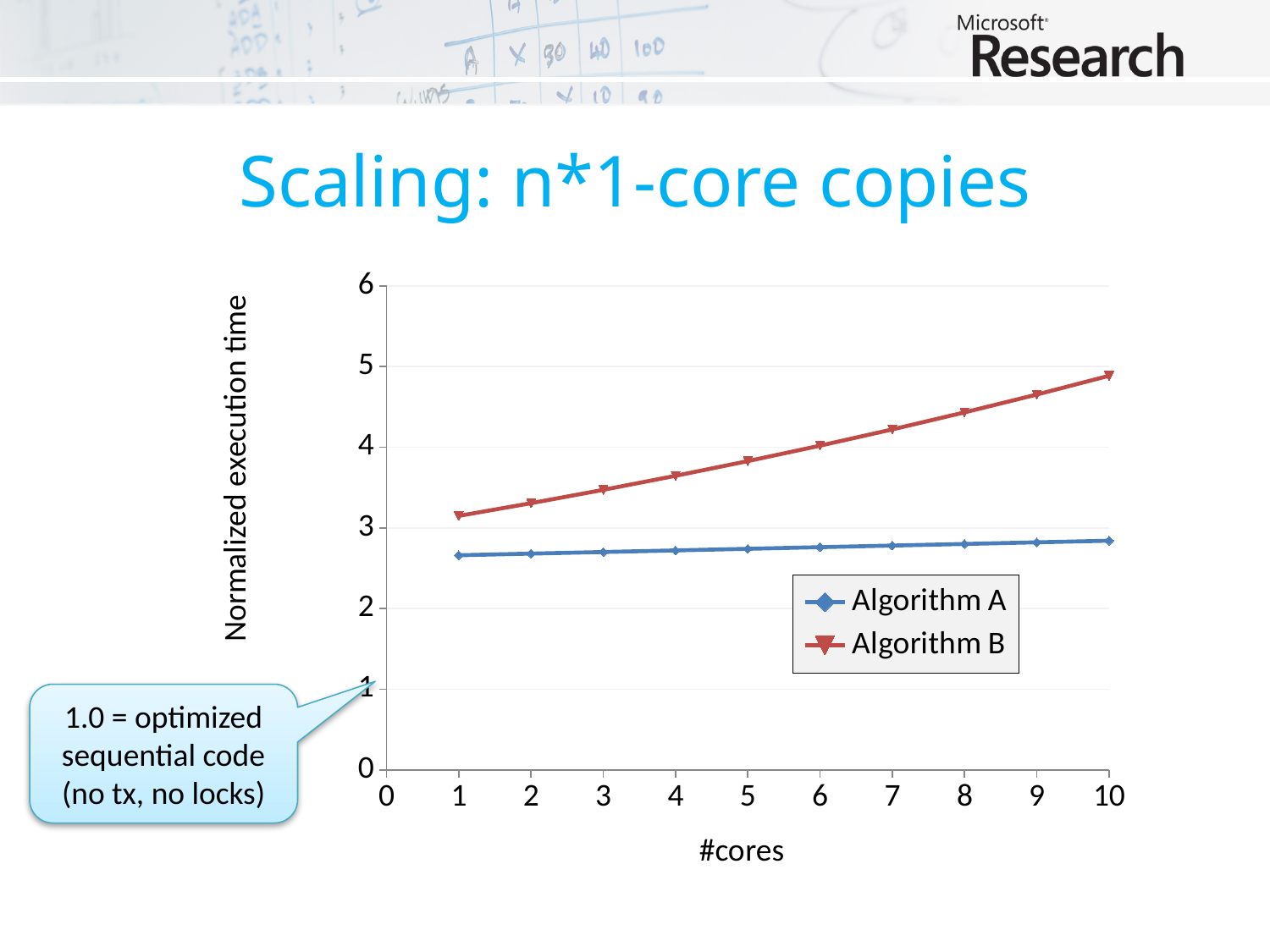
At which number of cores is the normalized execution time for Algorithm A lowest? 1 What are the names of the two series in the legend? Algorithm A and Algorithm B Does the normalized execution time for Algorithm B rise or fall as the number of cores increases? rise Is the value for Algorithm B at 10 cores greater or less than 4? greater How many series does the legend list? 2 Does the normalized execution time for Algorithm A rise or fall as the number of cores increases? rise How many data points are plotted for Algorithm B? 10 What kind of chart is shown on the slide? line chart Which series has the higher normalized execution time at 10 cores, Algorithm A or Algorithm B? Algorithm B At which number of cores is the normalized execution time for Algorithm B highest? 10 What is the title of the chart on the slide? Scaling: n*1-core copies Is the value for Algorithm A at 10 cores greater or less than 3? less